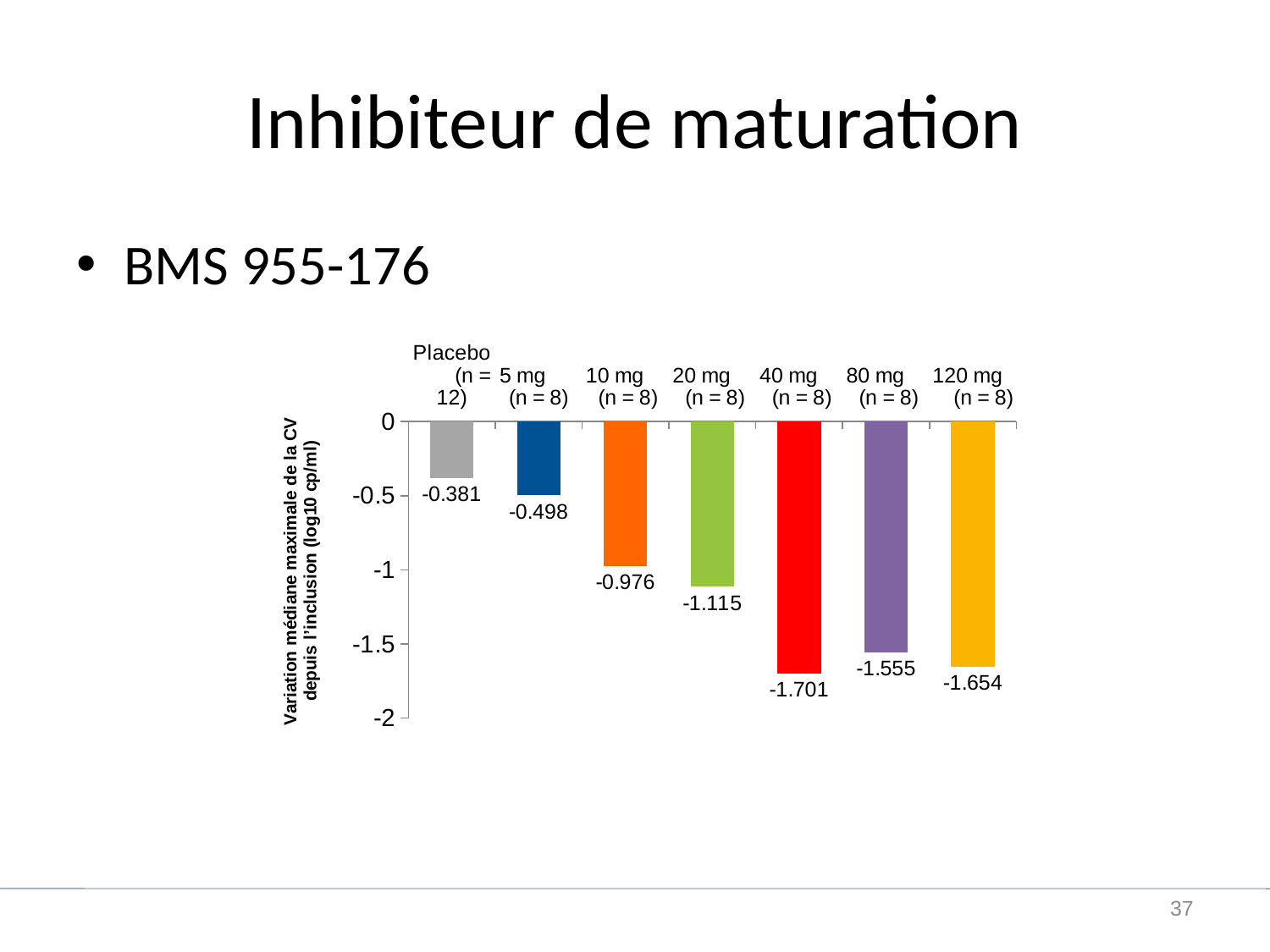
Which group has the lowest (most negative) value? 40 mg What is the value for the Placebo group? -0.381 Do the values rise or fall from Placebo to 40 mg along the x axis? fall What is the value for the 10 mg group? -0.976 Which group has the highest (least negative) value? Placebo Which group shows the larger decrease, 80 mg or 120 mg? 120 mg Is the value for the 20 mg group greater or less than -1? less What is the value for the 80 mg group? -1.555 How many dose groups are shown in the chart? 7 What is the difference between the values for the 5 mg group and the 10 mg group? 0.478 What is the difference between the values for the 40 mg group and the Placebo group? 1.320 What kind of chart is shown on the slide? bar chart